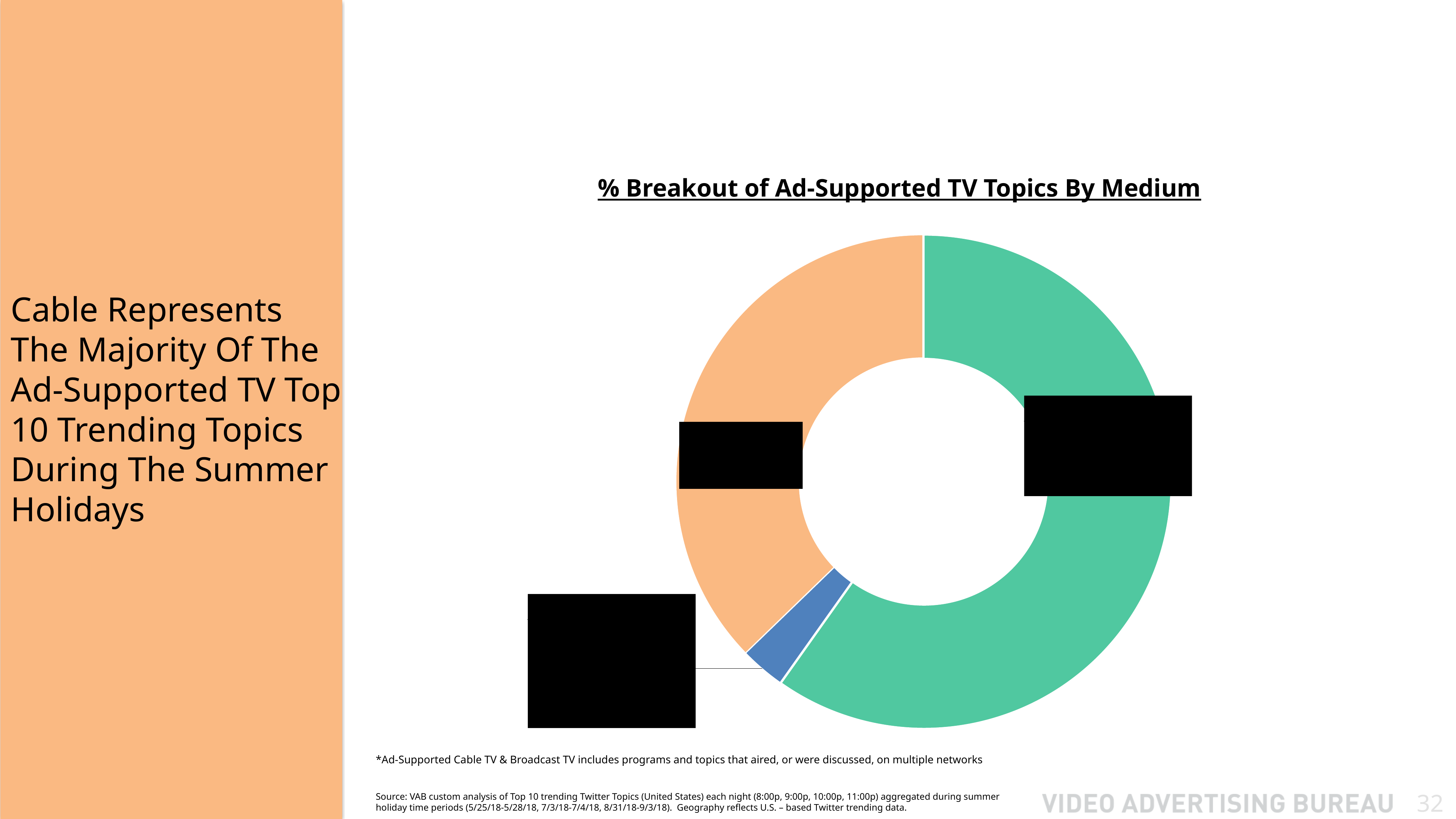
Which is larger, the green segment or the orange segment? green Which colour segment of the donut chart is the smallest? blue What is the title of the chart? % Breakout of Ad-Supported TV Topics By Medium What kind of chart is shown on the slide? donut (pie) chart What colours are used for the three segments of the donut chart? green, orange and blue How many segments does the donut chart have? 3 Does the green segment make up more or less than half of the donut chart? more Which colour segment of the donut chart is the largest? green Does the orange segment make up more or less than half of the donut chart? less